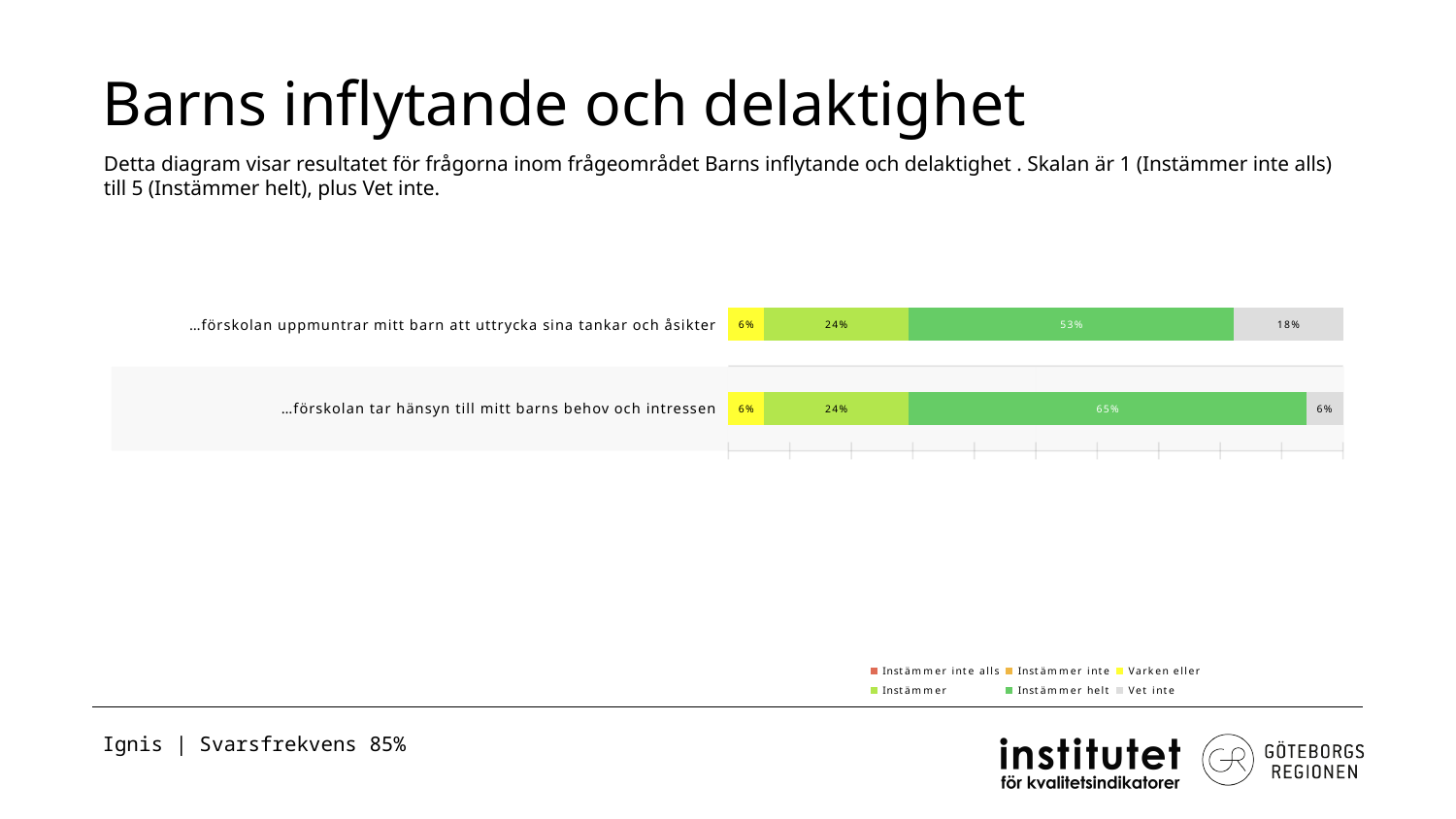
What type of chart is shown on the slide? Stacked bar chart What is the "Instämmer" share for "…förskolan tar hänsyn till mitt barns behov och intressen"? 24% What is the "Varken eller" share for "…förskolan uppmuntrar mitt barn att uttrycka sina tankar och åsikter"? 6% What is the "Vet inte" share for "…förskolan uppmuntrar mitt barn att uttrycka sina tankar och åsikter"? 18% What is the difference in percentage points between the "Instämmer helt" shares of the two statements? 12 What is the "Vet inte" share for "…förskolan tar hänsyn till mitt barns behov och intressen"? 6% How many statements (bars) are shown in the chart? 2 What percentage of respondents answered "Instämmer helt" for "…förskolan tar hänsyn till mitt barns behov och intressen"? 65% How many response categories does the legend list? 6 Which of the two statements has the higher "Instämmer helt" share? …förskolan tar hänsyn till mitt barns behov och intressen What percentage of respondents answered "Instämmer helt" for "…förskolan uppmuntrar mitt barn att uttrycka sina tankar och åsikter"? 53% Which response category has the largest share for "…förskolan uppmuntrar mitt barn att uttrycka sina tankar och åsikter"? Instämmer helt